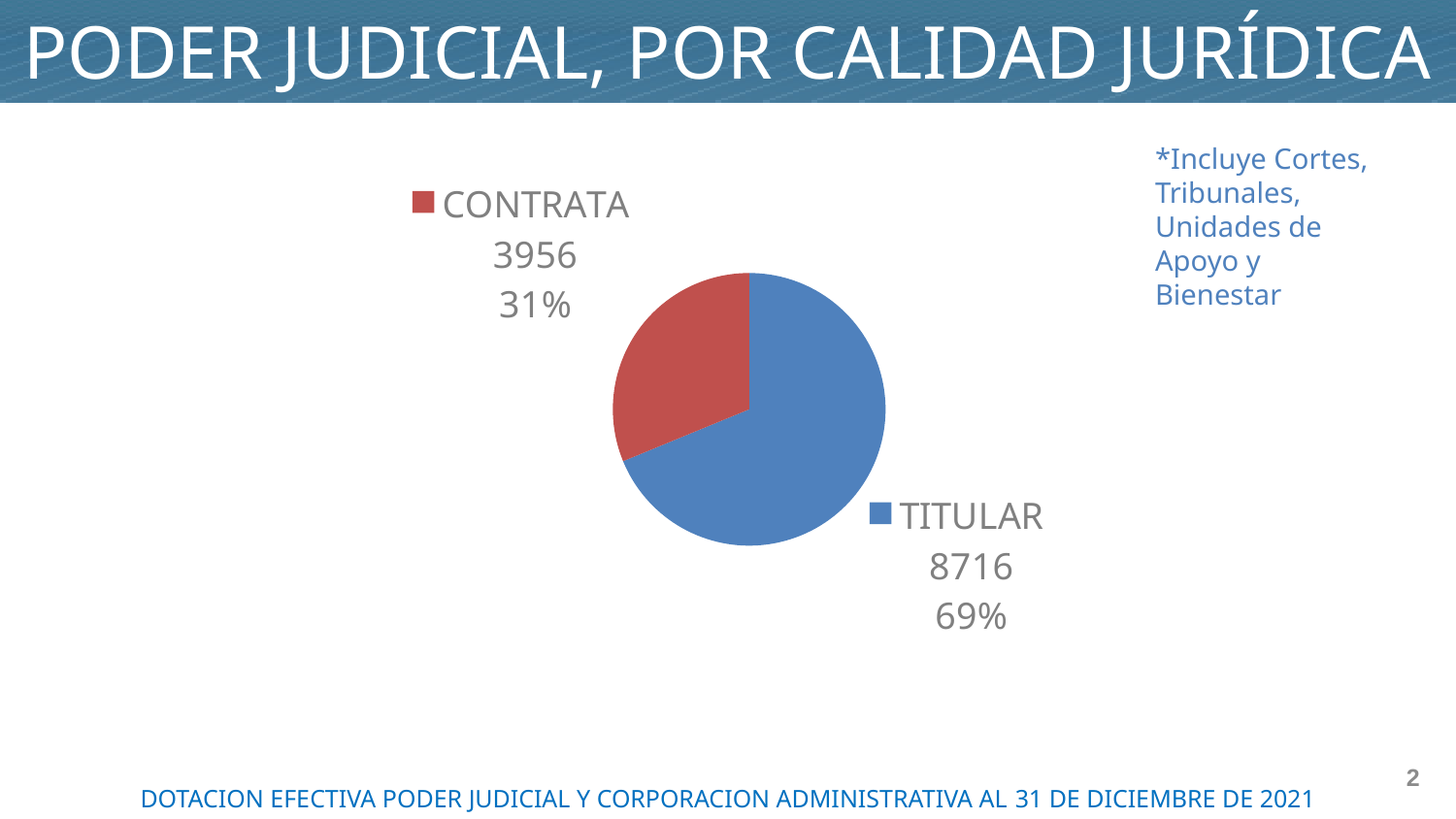
What percentage share does CONTRATA have in the pie chart? 31% What is the difference between the TITULAR and CONTRATA values? 4760 Which category has the largest slice of the pie? TITULAR What is the value for TITULAR? 8716 Which is larger, TITULAR or CONTRATA? TITULAR What is the total of the TITULAR and CONTRATA values? 12672 What colour is the CONTRATA slice? Red What is the value for CONTRATA? 3956 What kind of chart is shown on the slide? Pie chart What percentage share does TITULAR have in the pie chart? 69% Which category has the smallest slice of the pie? CONTRATA How many categories are shown in the pie chart? 2